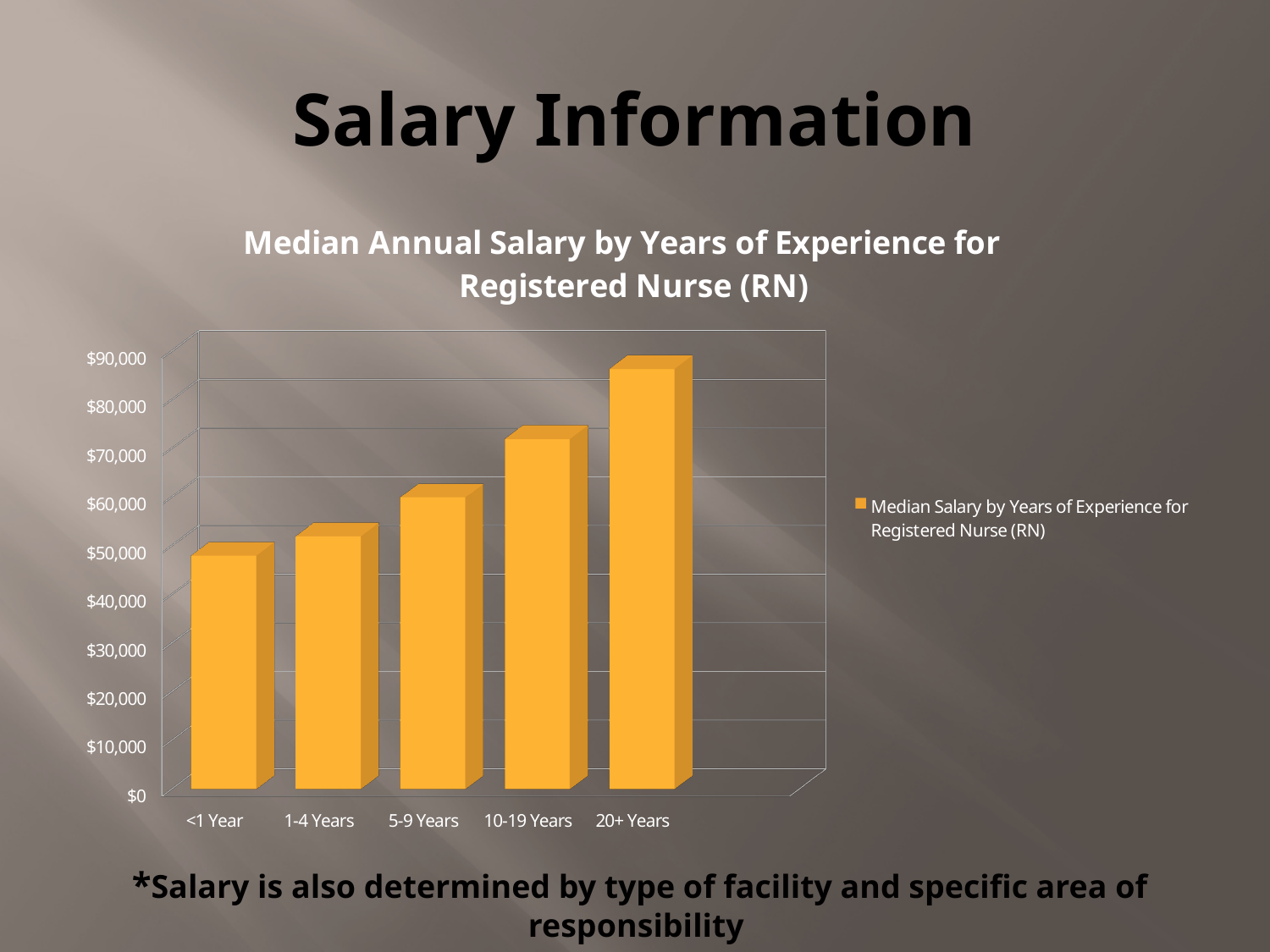
Which experience category has the highest median salary? 20+ Years What is the title of the chart? Median Annual Salary by Years of Experience for Registered Nurse (RN) Which experience category has the lowest median salary? <1 Year Is the median salary for 5-9 Years greater or less than $70,000? less How many series does the chart legend list? 1 How many experience categories are shown on the x axis of the chart? 5 Do median salaries rise or fall as years of experience increase along the x axis? rise Which has a higher median salary, 10-19 Years or 5-9 Years? 10-19 Years Is the median salary for 20+ Years greater or less than $80,000? greater What kind of chart is shown on the slide? bar chart Is the median salary for 1-4 Years greater or less than $60,000? less